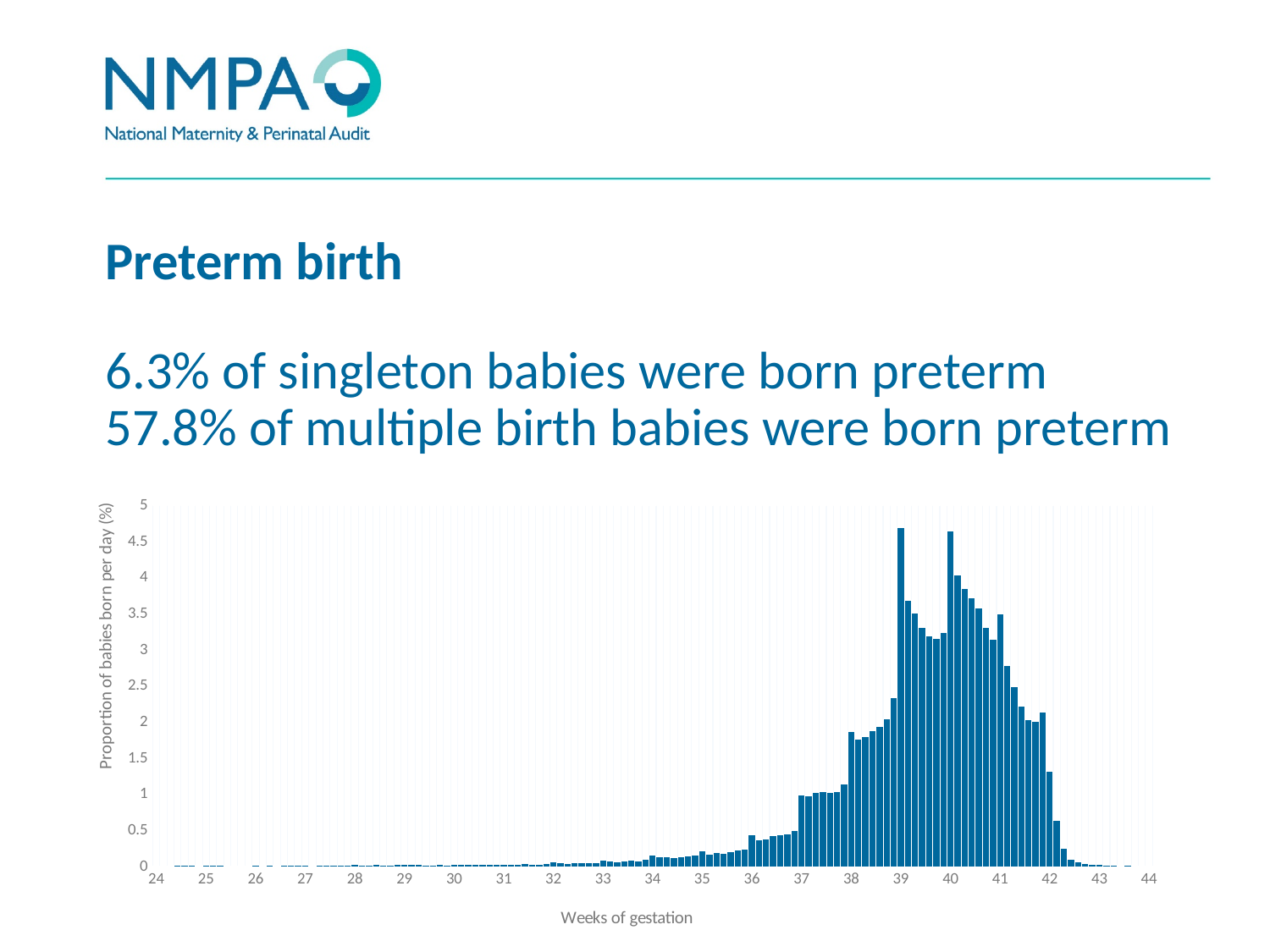
What is the title of the x axis of the chart? Weeks of gestation At which week of gestation label does the tallest bar in the chart occur? 39 How many week labels are shown on the x axis of the chart? 21 Is the value of the bar at 38 weeks of gestation greater or less than 2? less Is the value of the bar at 35 weeks of gestation greater or less than 0.5? less What is the title of the y axis of the chart? Proportion of babies born per day (%) Which is larger, the bar at 38 weeks of gestation or the bar at 42 weeks of gestation? 38 weeks Is the value of the bar at 38 weeks of gestation greater or less than 1.5? greater Do the values generally rise or fall along the x axis between 30 and 39 weeks of gestation? rise What kind of chart is shown on the slide? Bar chart